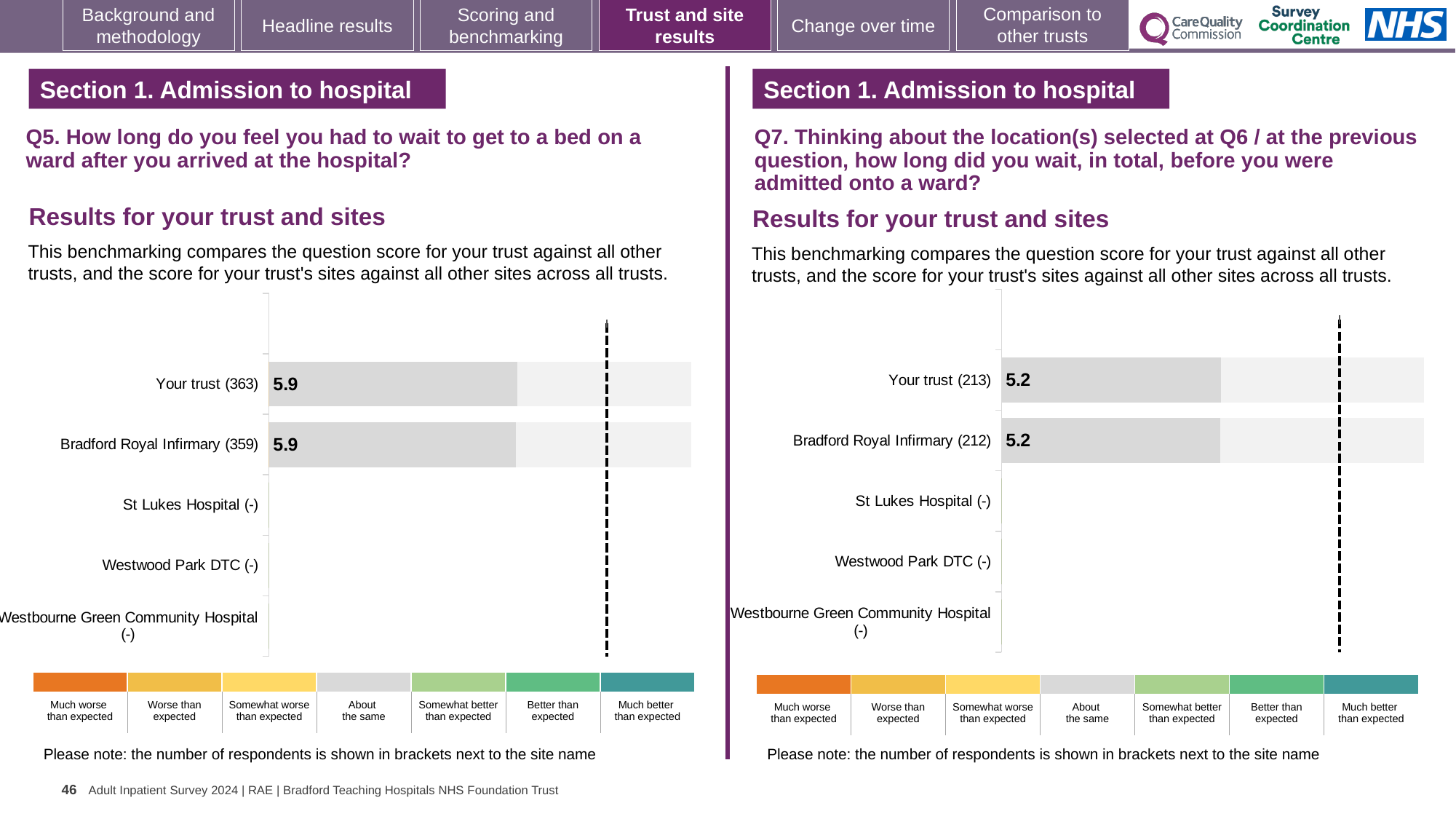
In the Q5 chart on the left, what is the score for Bradford Royal Infirmary? 5.9 In the Q5 chart on the left, which category label is shown for the bottom row? Westbourne Green Community Hospital (-) In the Q5 chart on the left, what is the difference between the score for Your trust and the score for Bradford Royal Infirmary? 0 In the Q5 chart on the left, what is the score for Your trust? 5.9 In the colour key below the Q7 chart on the right, which category is shown in grey? About the same What kind of chart is the Q7 chart on the right? Bar chart How many site/trust categories are listed on the vertical axis of the Q7 chart on the right? 5 In the Q7 chart on the right, what is the score for Your trust? 5.2 In the Q5 chart on the left, how many respondents are shown in brackets for Bradford Royal Infirmary? 359 How many site/trust categories are listed on the vertical axis of the Q5 chart on the left? 5 In the Q7 chart on the right, what is the score for Bradford Royal Infirmary? 5.2 In the Q7 chart on the right, how many respondents are shown in brackets for Your trust? 213